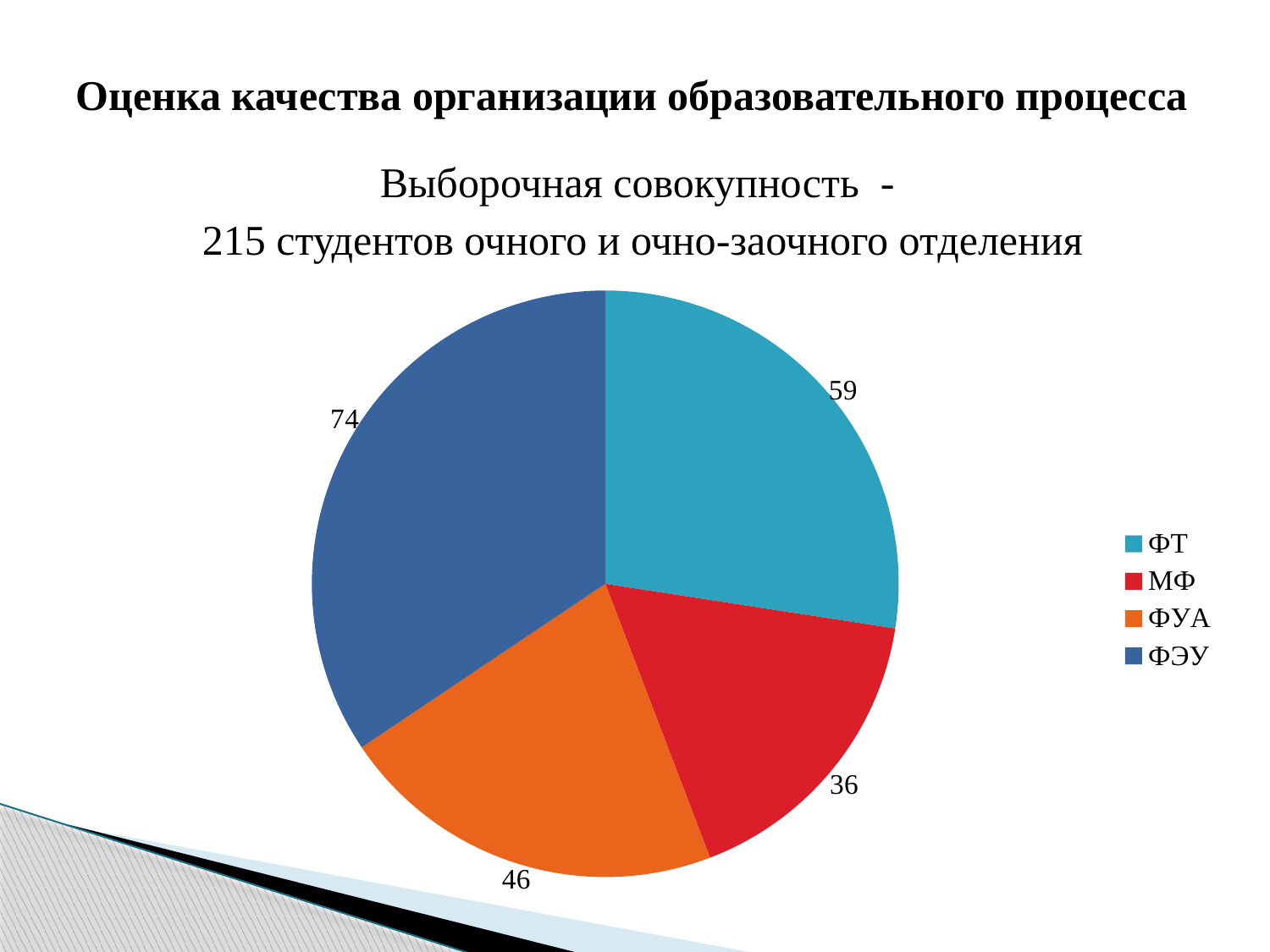
What is the difference between the values for ФУА and МФ? 10 Which category has the smallest slice in the pie chart? МФ What value is shown for ФЭУ in the pie chart? 74 What is the total of all the values shown in the pie chart? 215 How many categories does the pie chart show? 4 Which category has the largest slice in the pie chart? ФЭУ What is the difference between the values for ФЭУ and ФТ? 15 What value is shown for ФУА in the pie chart? 46 Which is larger, the value for ФТ or the value for ФУА? ФТ What value is shown for МФ in the pie chart? 36 What value is shown for ФТ in the pie chart? 59 What type of chart is shown on the slide? Pie chart